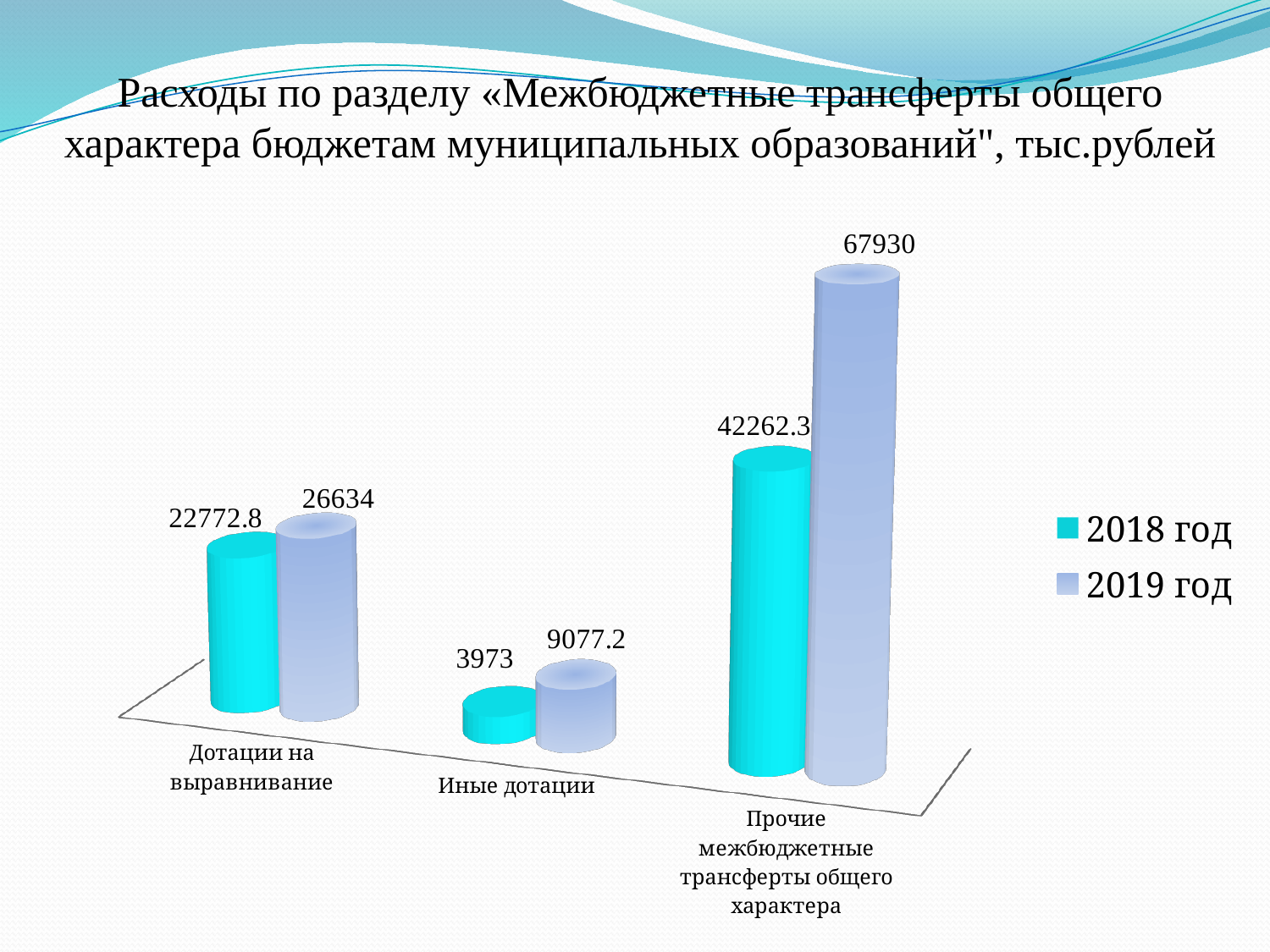
What is the value for 2018 год for Дотации на выравнивание? 22772.8 How many series does the legend list? 2 What is the value for 2018 год for Иные дотации? 3973 Which is larger for Иные дотации: the 2018 год value or the 2019 год value? 2019 год What is the value for 2019 год for Прочие межбюджетные трансферты общего характера? 67930 What is the value for 2019 год for Иные дотации? 9077.2 Which category has the highest value for 2019 год? Прочие межбюджетные трансферты общего характера What kind of chart is shown on the slide? Bar chart How many categories are shown on the x axis? 3 Which category has the lowest value for 2018 год? Иные дотации What is the difference between the 2019 год and 2018 год values for Дотации на выравнивание? 3861.2 What is the difference between the 2019 год and 2018 год values for Прочие межбюджетные трансферты общего характера? 25667.7